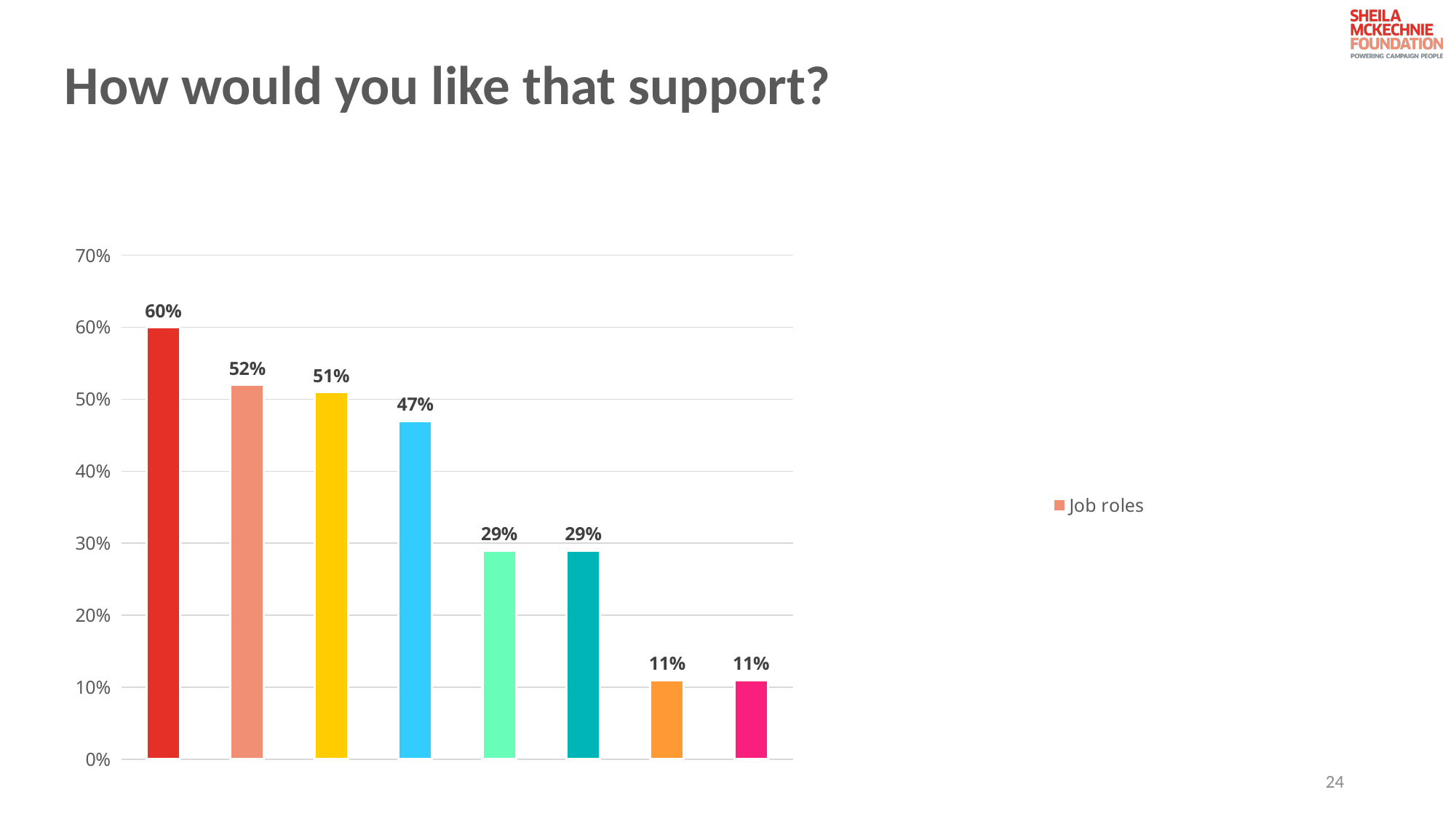
Which is larger, the value of the second bar from the left or the value of the fourth bar from the left? the second bar (52%) What is the legend entry shown next to the chart? Job roles What is the value of the yellow bar (third from the left)? 51% What is the difference between the first bar (60%) and the second bar (52%)? 8% What type of chart is shown on the slide? bar chart What is the value of the first (red) bar from the left? 60% Do the bar values rise or fall from left to right across the chart? fall What is the value of the light blue bar (fourth from the left)? 47% What is the lowest value shown in the chart? 11% How many bars are plotted in the chart? 8 What is the highest value shown in the chart? 60% How many series does the legend list? 1